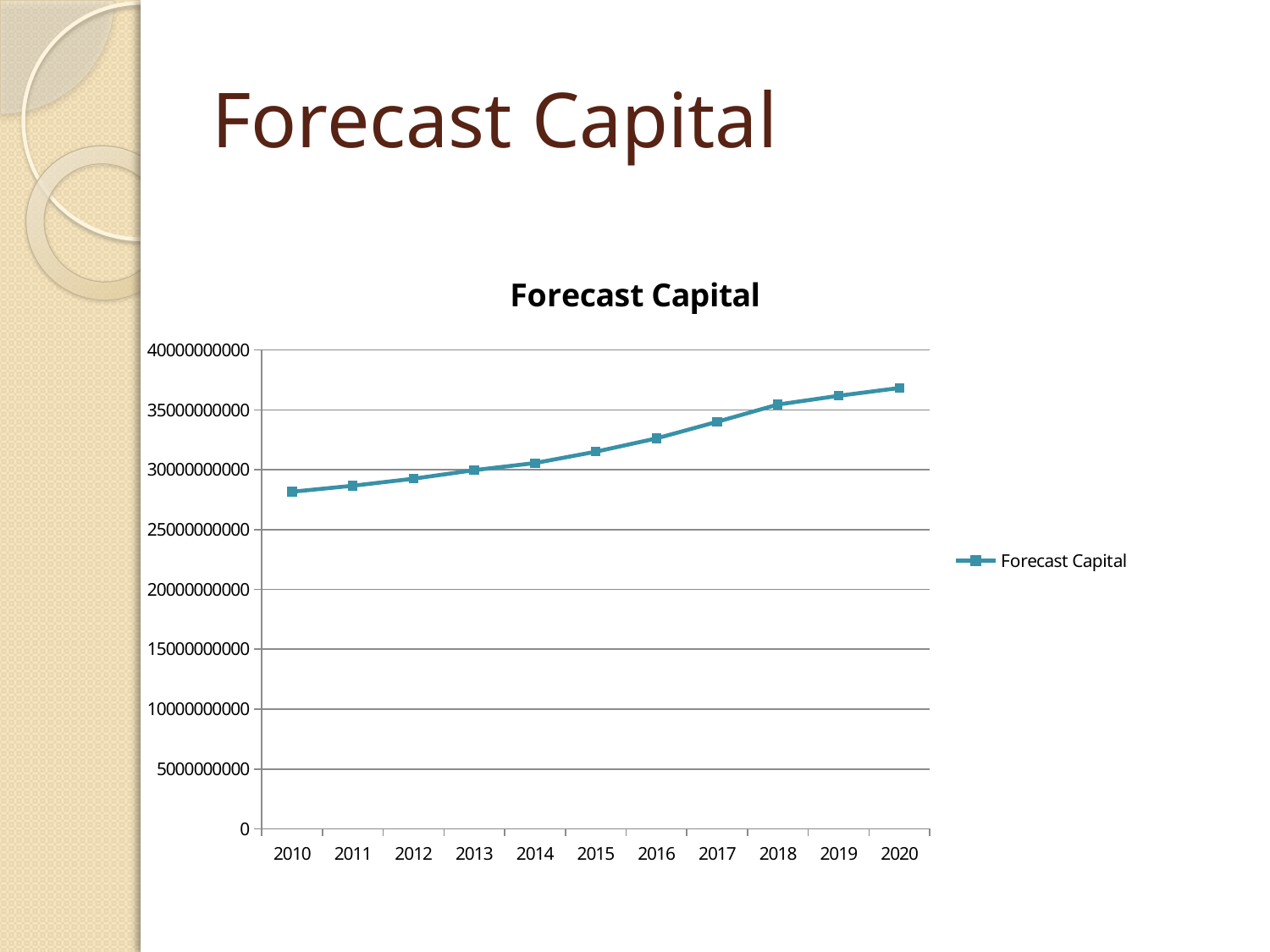
Which year has the lowest Forecast Capital value? 2010 Is the value for 2015 greater or less than 35000000000? less Do the Forecast Capital values rise or fall from 2010 to 2020? rise Which year has the larger Forecast Capital value, 2012 or 2018? 2018 Which year has the highest Forecast Capital value? 2020 How many years are plotted on the x axis? 11 What is the title of the chart? Forecast Capital Is the value for 2016 greater or less than 30000000000? greater Is the value for 2010 greater or less than 30000000000? less How many series does the legend list? 1 What kind of chart is shown on the slide? line chart